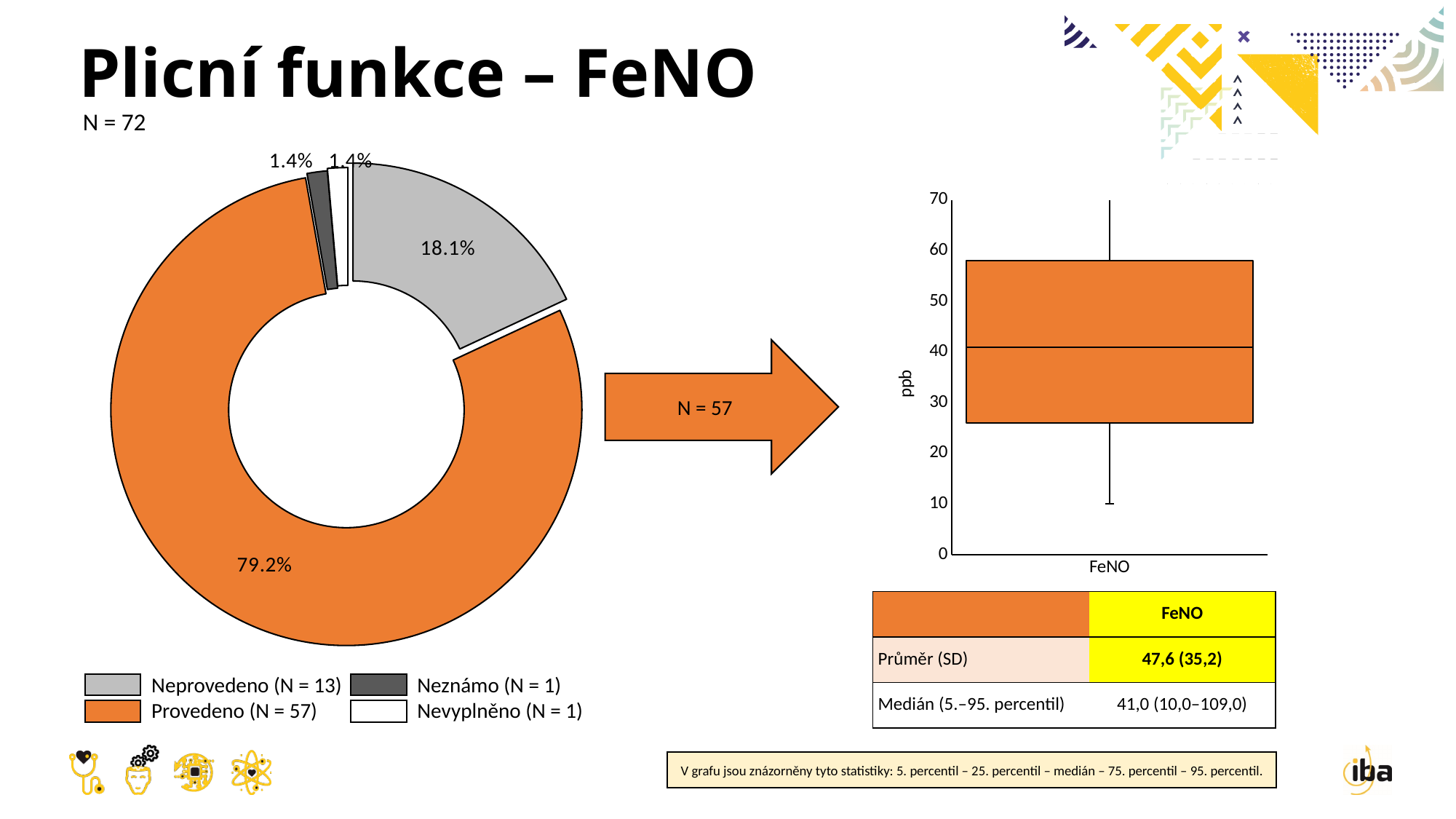
On the donut chart, what percentage share does the Neprovedeno category have? 18.1% What is the y-axis unit label on the FeNO box plot? ppb On the donut chart, what percentage share does the Provedeno category have? 79.2% On the donut chart, which category has the largest share? Provedeno On the donut chart, what percentage share does the Neznámo category have? 1.4% What is the difference in percentage points between the Provedeno and Neprovedeno shares on the donut chart? 61.1 percentage points On the FeNO box plot, is the median line greater or less than 30 ppb? greater What kind of chart is shown on the left side of the slide? Pie (donut) chart On the donut chart, which is larger, the share for Provedeno or the share for Neprovedeno? Provedeno What kind of chart is shown on the right side of the slide, labelled FeNO? Box plot How many categories does the donut chart's legend list? 4 According to the legend of the donut chart, what is the N for Neprovedeno? N = 13